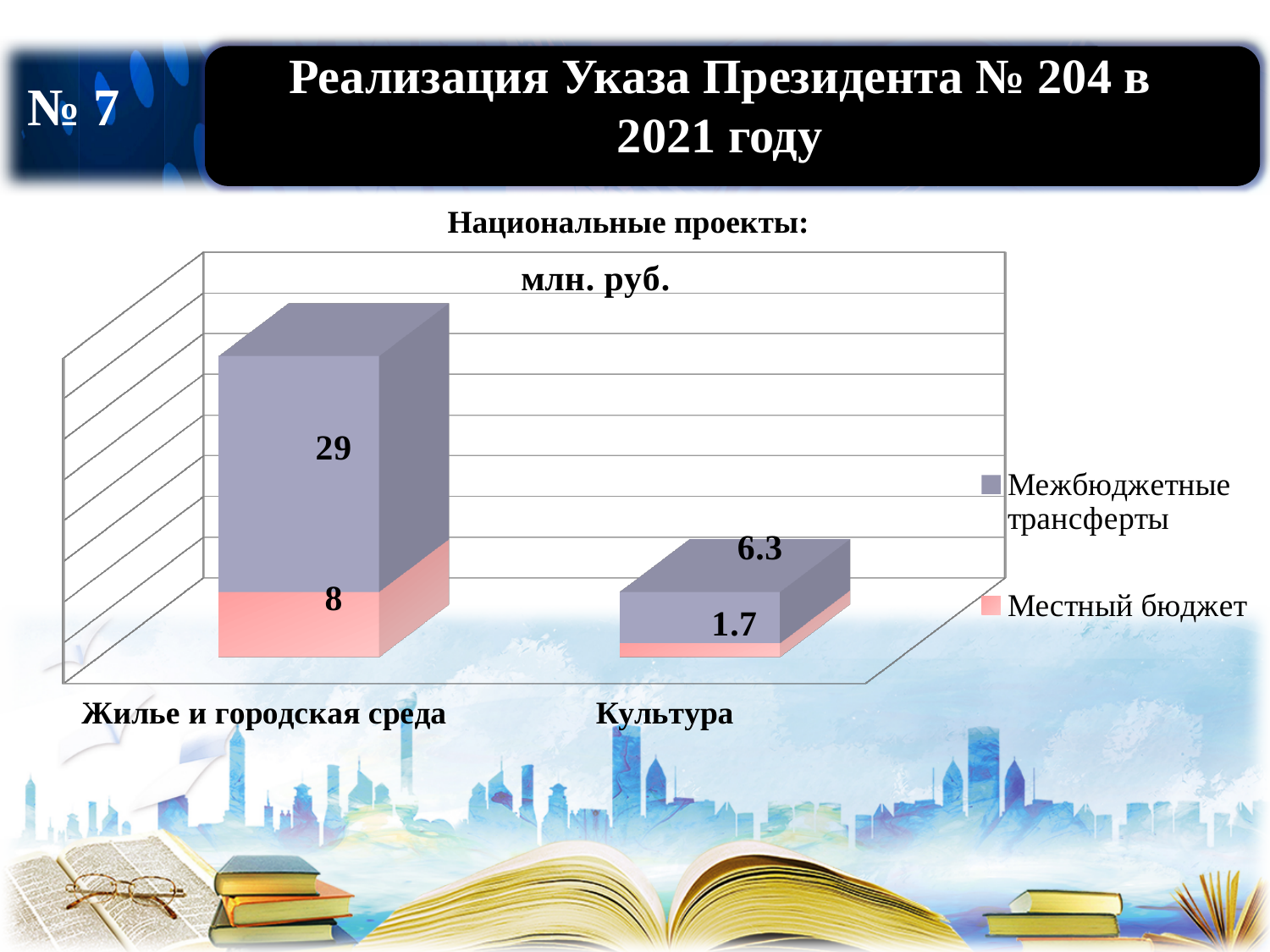
Which category has the highest value for Межбюджетные трансферты? Жилье и городская среда What is the total of the stacked bar for Культура? 8 What is the value of Межбюджетные трансферты for Культура? 6.3 What is the value of Межбюджетные трансферты for Жилье и городская среда? 29 What is the difference between the Межбюджетные трансферты values for Жилье и городская среда and Культура? 22.7 What is the total of the stacked bar for Жилье и городская среда? 37 What is the value of Местный бюджет for Жилье и городская среда? 8 What is the value of Местный бюджет for Культура? 1.7 How many categories are shown on the x axis? 2 How many series does the legend list? 2 Which is larger: Местный бюджет for Жилье и городская среда or Межбюджетные трансферты for Культура? Местный бюджет for Жилье и городская среда Which category has the lowest value for Местный бюджет? Культура